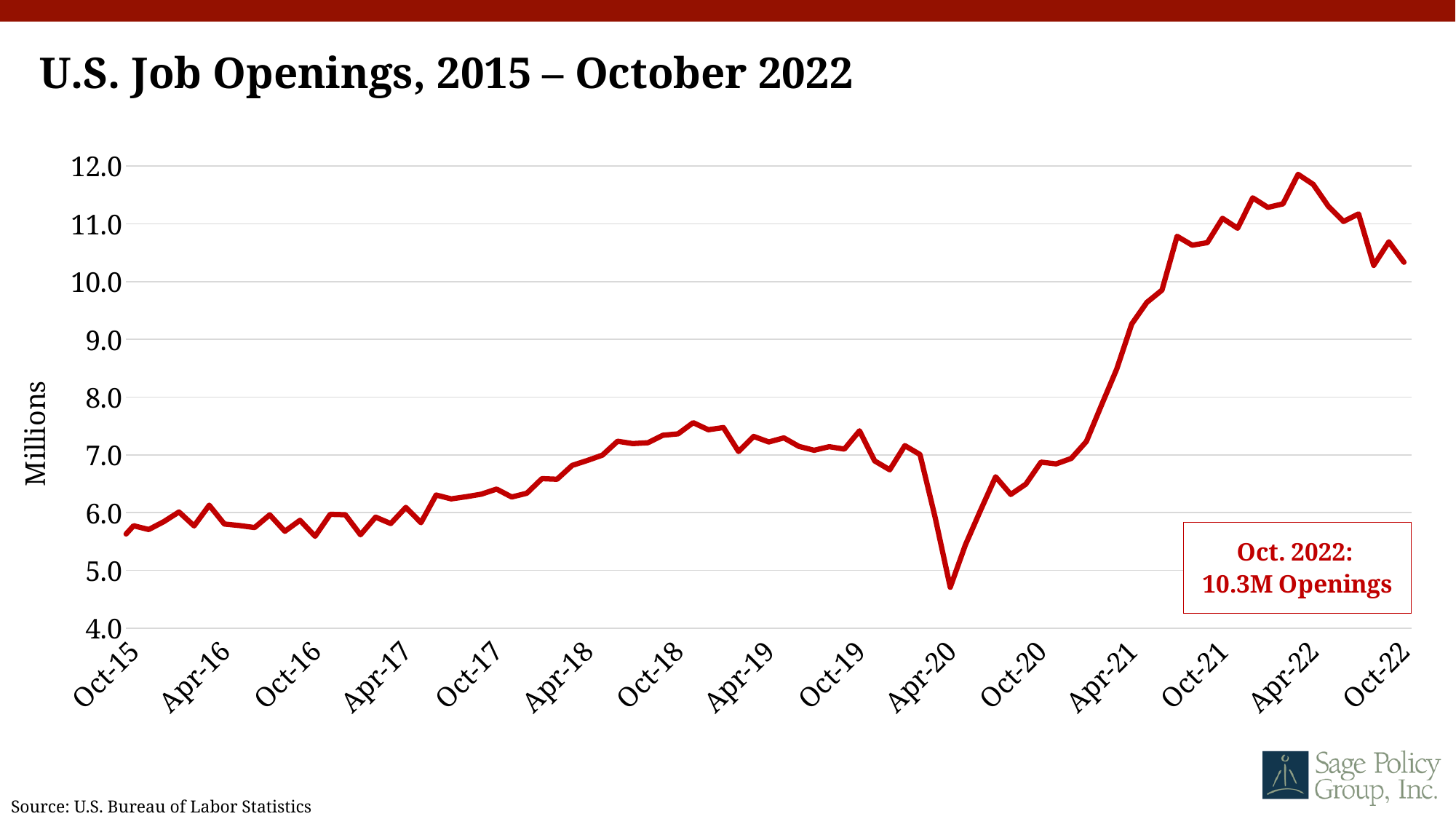
What is the number of U.S. job openings in October 2022 according to the callout on the chart? 10.3M What kind of chart is shown on the slide? line chart Between Apr-20 and Apr-22, does the line generally rise or fall? rise Is the value for Oct-15 greater or less than 6.0 million? less Near which x-axis label does the line reach its lowest point? Apr-20 Near which x-axis label does the line reach its highest point? Apr-22 How many labels are shown on the x axis? 15 Is the value for Oct-18 greater or less than 7.0 million? greater Is the value for Apr-20 greater or less than 5.0 million? less What is the label on the y axis? Millions Which is larger, the value at Oct-21 or the value at Oct-16? Oct-21